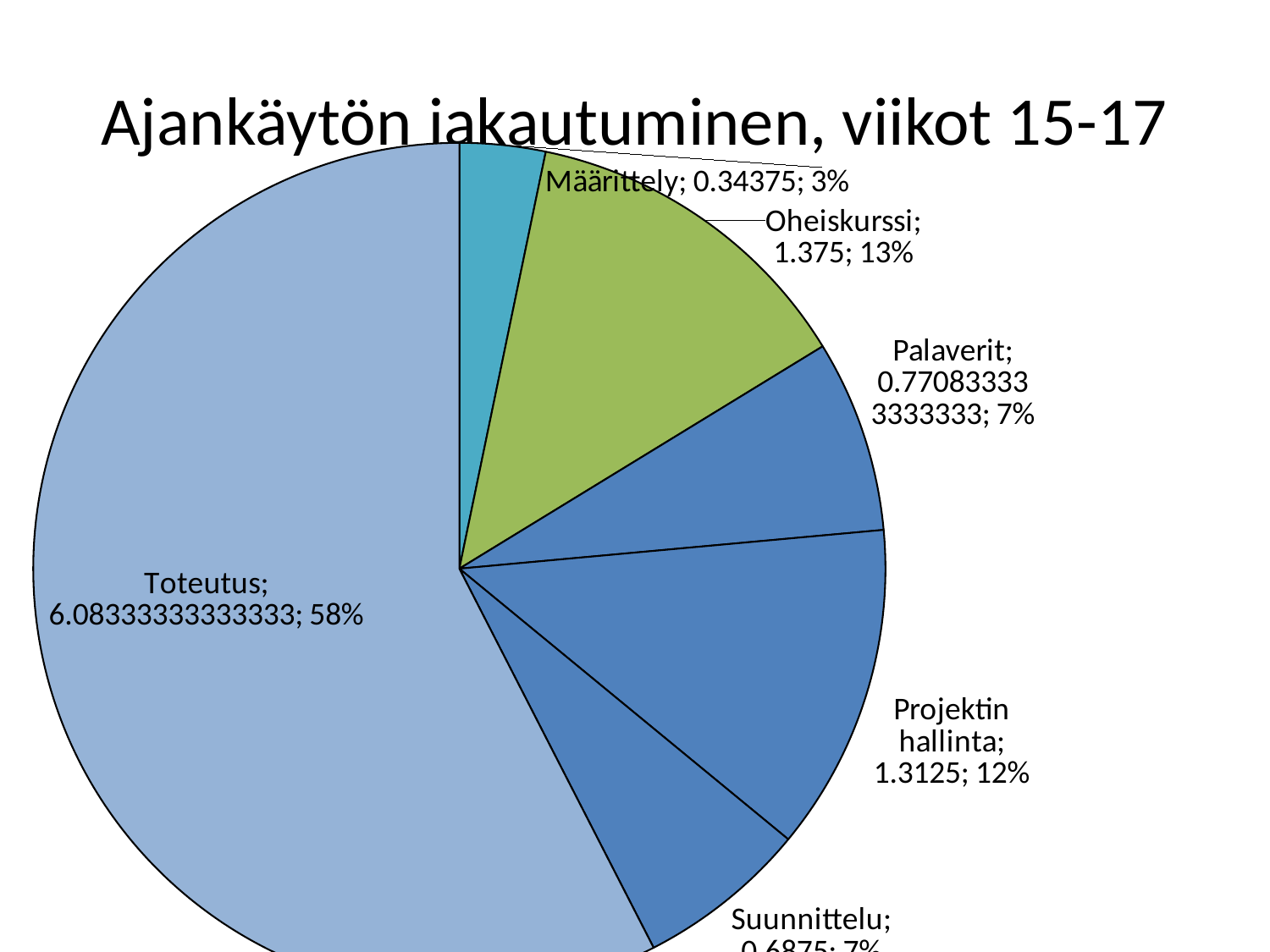
Which category has the largest slice of the pie? Toteutus What share of the pie does Toteutus take? 58% What kind of chart is shown on the slide? pie chart Which is larger, the value for Oheiskurssi or the value for Määrittely? Oheiskurssi Which category has the smallest slice of the pie? Määrittely What is the value shown for Määrittely? 0.34375 What share of the pie does Oheiskurssi take? 13% What share of the pie does Määrittely take? 3% What is the value shown for Projektin hallinta? 1.3125 What is the title of the chart? Ajankäytön jakautuminen, viikot 15-17 What is the value shown for Oheiskurssi? 1.375